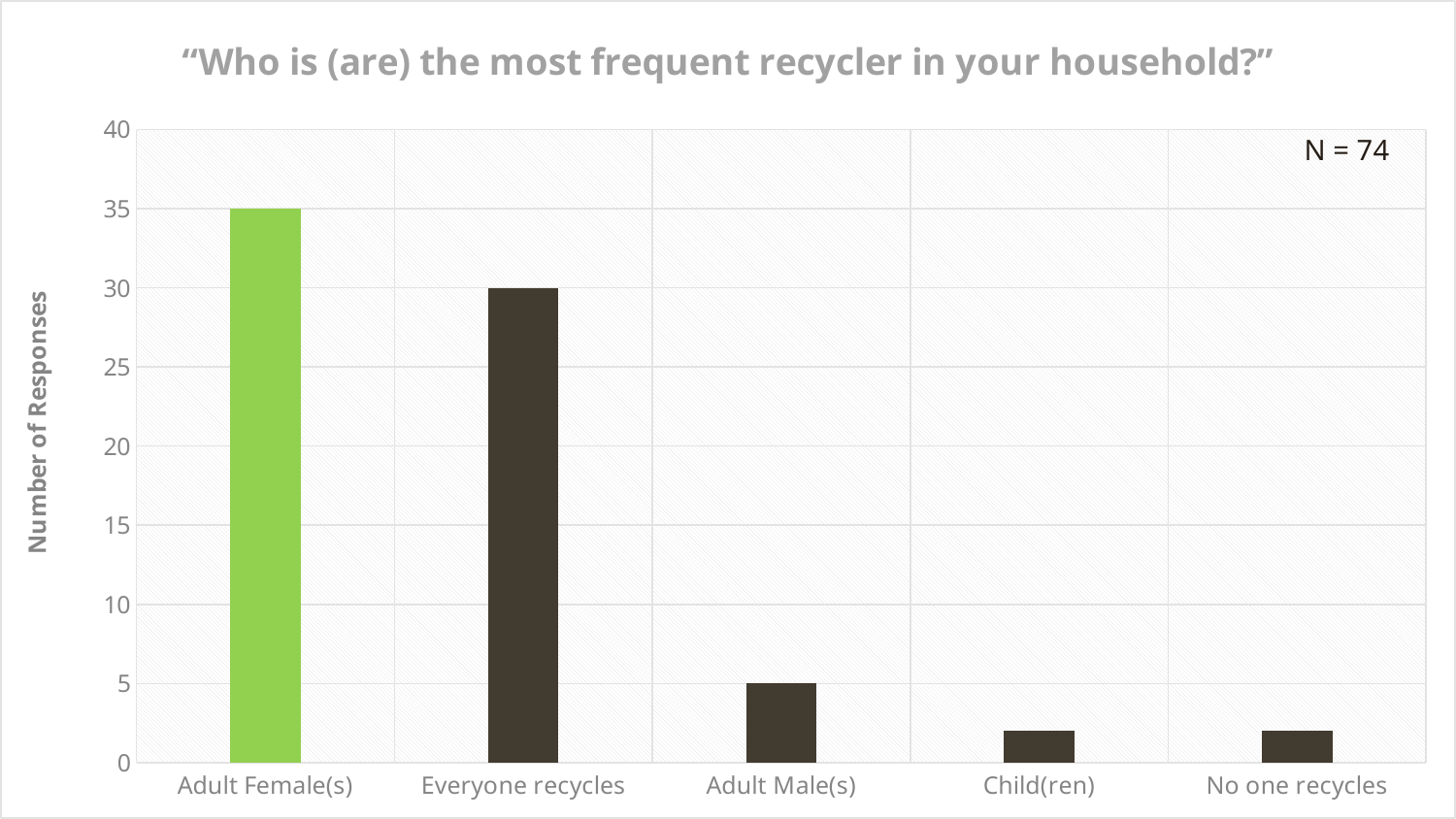
Is the value for No one recycles greater or less than 5? less What is the difference in responses between Everyone recycles and Adult Male(s)? 25 What is the difference in responses between Adult Female(s) and Everyone recycles? 5 What is the number of responses for Everyone recycles? 30 What is the number of responses for Adult Female(s)? 35 Which has more responses, Everyone recycles or Adult Male(s)? Everyone recycles Is the value for Child(ren) greater or less than 5? less What sample size (N) is shown on the chart? N = 74 Which category has the highest number of responses? Adult Female(s) How many categories are shown on the x axis? 5 What kind of chart is this? bar chart What is the number of responses for Adult Male(s)? 5